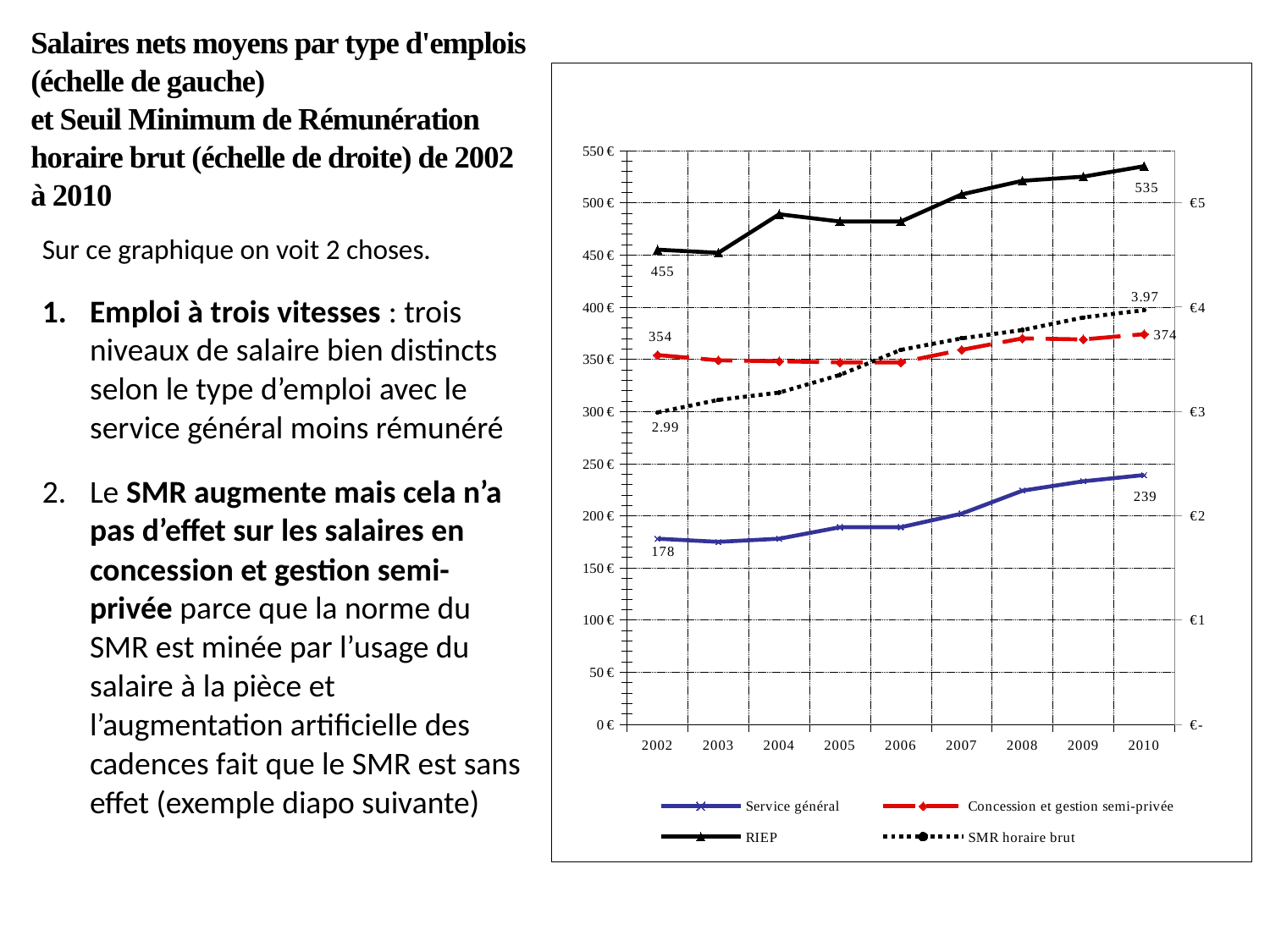
How many series does the legend list? 4 What is the value for RIEP in 2010? 535 Which series has the highest values on the left scale across all years? RIEP What type of chart is shown on the slide? line chart What is the value for Service général in 2002? 178 By how much did the Service général value increase from 2002 to 2010? 61 How many years are shown on the x axis? 9 Does the Service général series rise or fall from 2002 to 2010? rise By how much did the RIEP value increase from 2002 to 2010? 80 What is the value for Concession et gestion semi-privée in 2010? 374 What is the value for SMR horaire brut in 2002? 2.99 What is the value for RIEP in 2002? 455